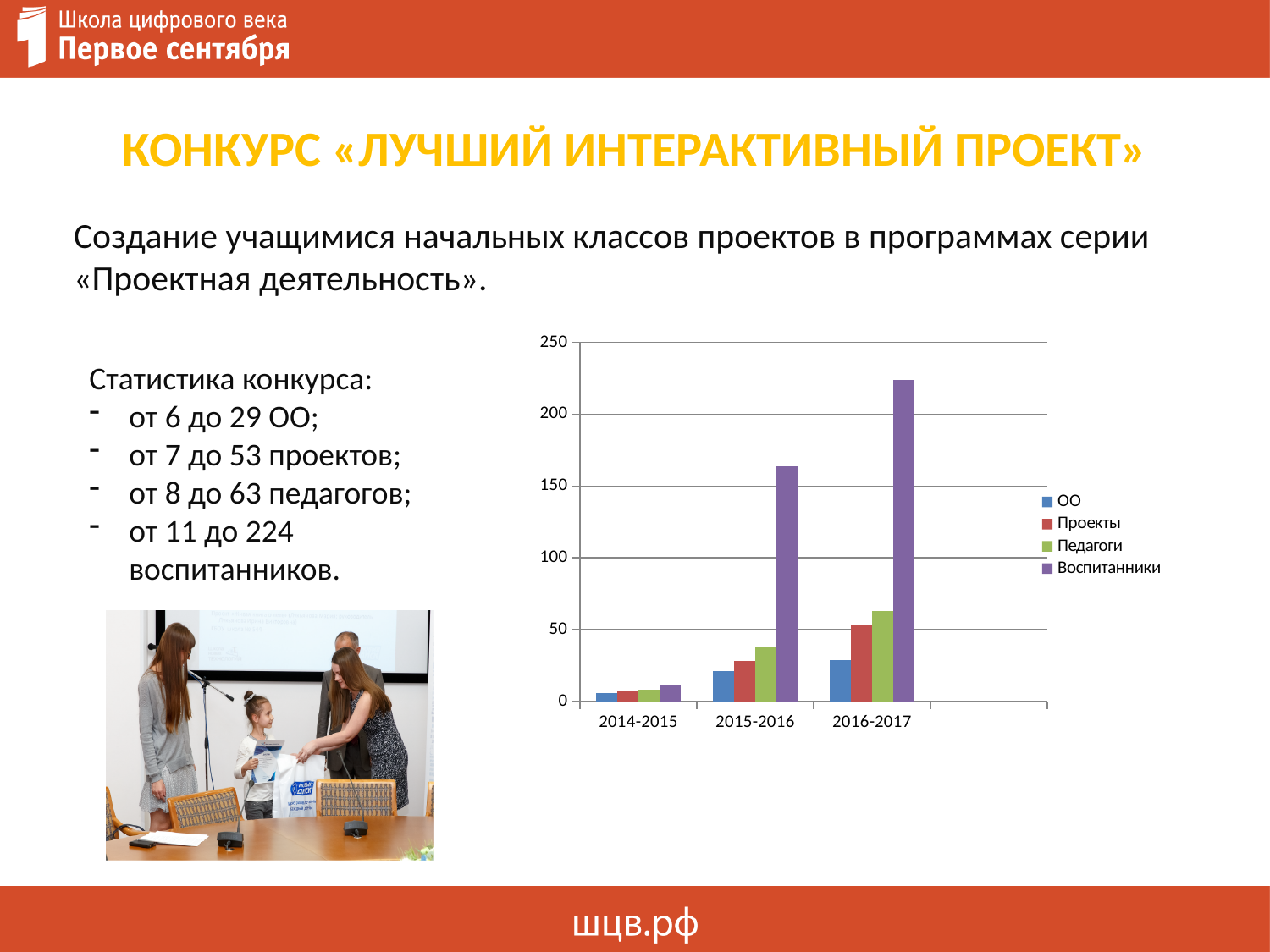
In which academic year is the value for Воспитанники the lowest? 2014-2015 How many categories (academic years) are shown on the x axis of the chart? 3 Is the value for Воспитанники in 2016-2017 greater or less than 200? greater Is the value for Воспитанники in 2015-2016 greater or less than 150? greater Is the value for Воспитанники in 2014-2015 greater or less than 50? less In which academic year is the value for Воспитанники the highest? 2016-2017 Which series has the highest value in 2016-2017? Воспитанники Which is larger in 2016-2017: the value for Педагоги or the value for ОО? Педагоги How many series does the chart legend list? 4 What kind of chart is shown on the slide? bar chart Do the values for Воспитанники rise or fall from 2014-2015 to 2016-2017? rise